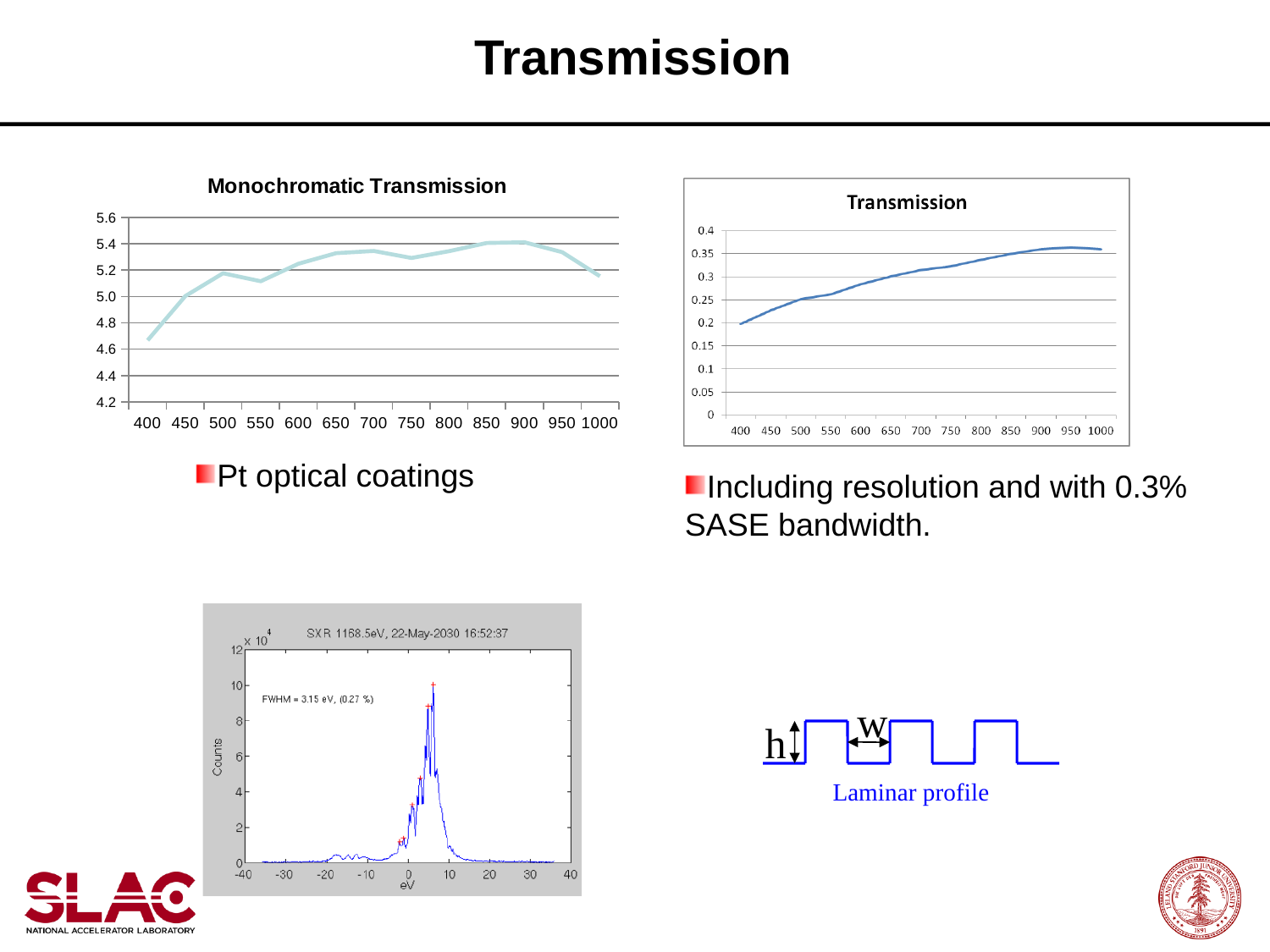
How many x-axis tick labels does the "Transmission" chart on the right show? 13 In the "Monochromatic Transmission" chart, is the value at 700 greater or less than 5.2? greater In the "Transmission" chart on the right, does the value generally rise or fall from 400 to 900? rise In the "Transmission" chart on the right, is the value at 400 greater or less than 0.25? less What is the title of the line chart on the left of the slide? Monochromatic Transmission In the "Transmission" chart on the right, is the value at 1000 greater or less than 0.35? greater What kind of chart is the "Transmission" chart on the right? line chart In the "Monochromatic Transmission" chart, which is larger, the value at 400 or the value at 1000? 1000 In the "Transmission" chart on the right, at which x-axis value is the transmission lowest? 400 What kind of chart is the "Monochromatic Transmission" chart? line chart In the "Monochromatic Transmission" chart, at which x-axis value is the transmission lowest? 400